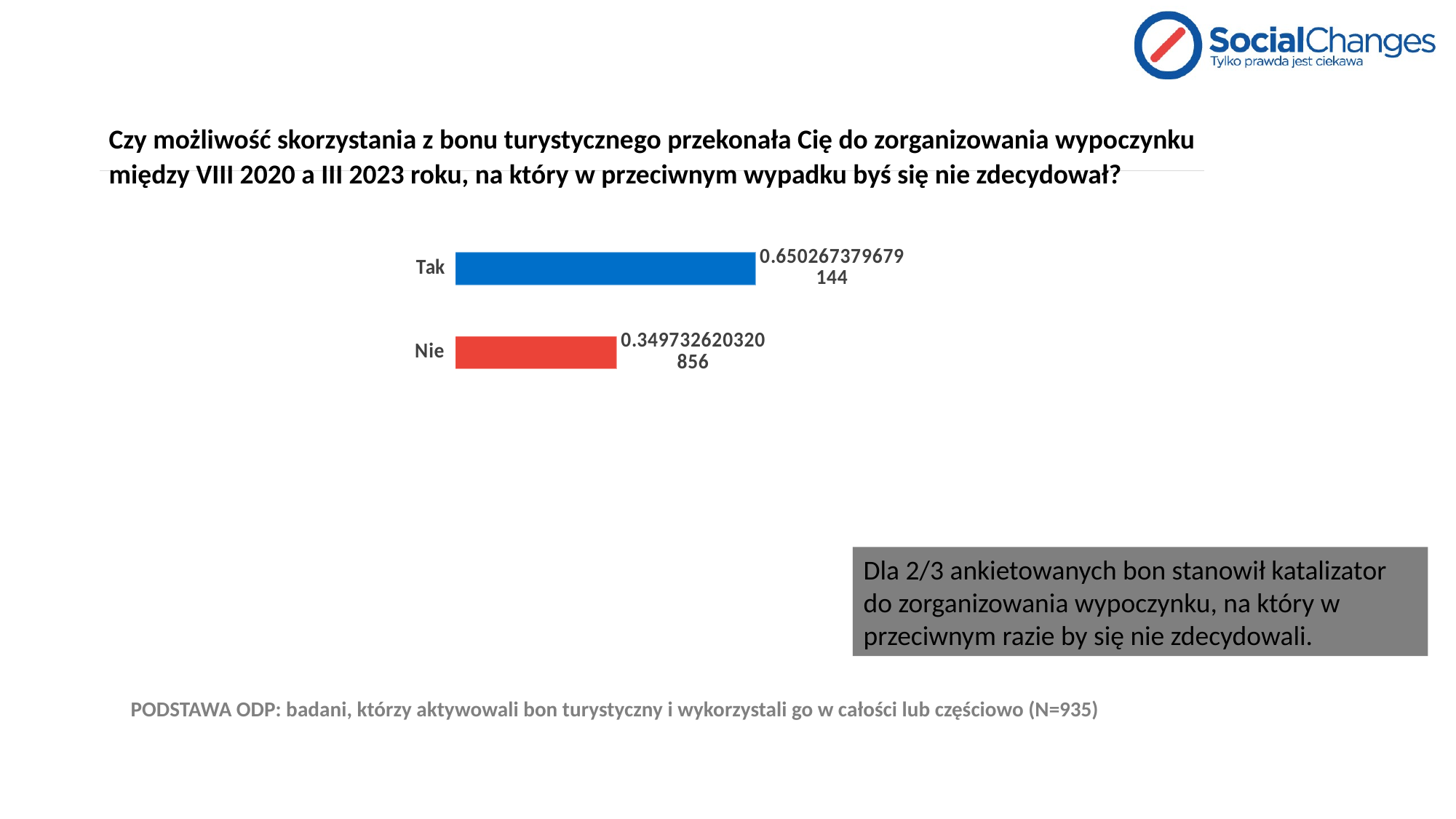
What colour is the bar for "Nie"? Red What colour is the bar for "Tak"? Blue What is the value shown for "Tak"? 0.650267379679144 How many categories are shown in the chart? 2 Which is larger, the value for "Tak" or the value for "Nie"? Tak What is the difference between the value for "Tak" and the value for "Nie"? 0.300534759358288 What kind of chart is shown on the slide? Bar chart Which category has the lowest value? Nie What is the value shown for "Nie"? 0.349732620320856 Which category has the highest value? Tak